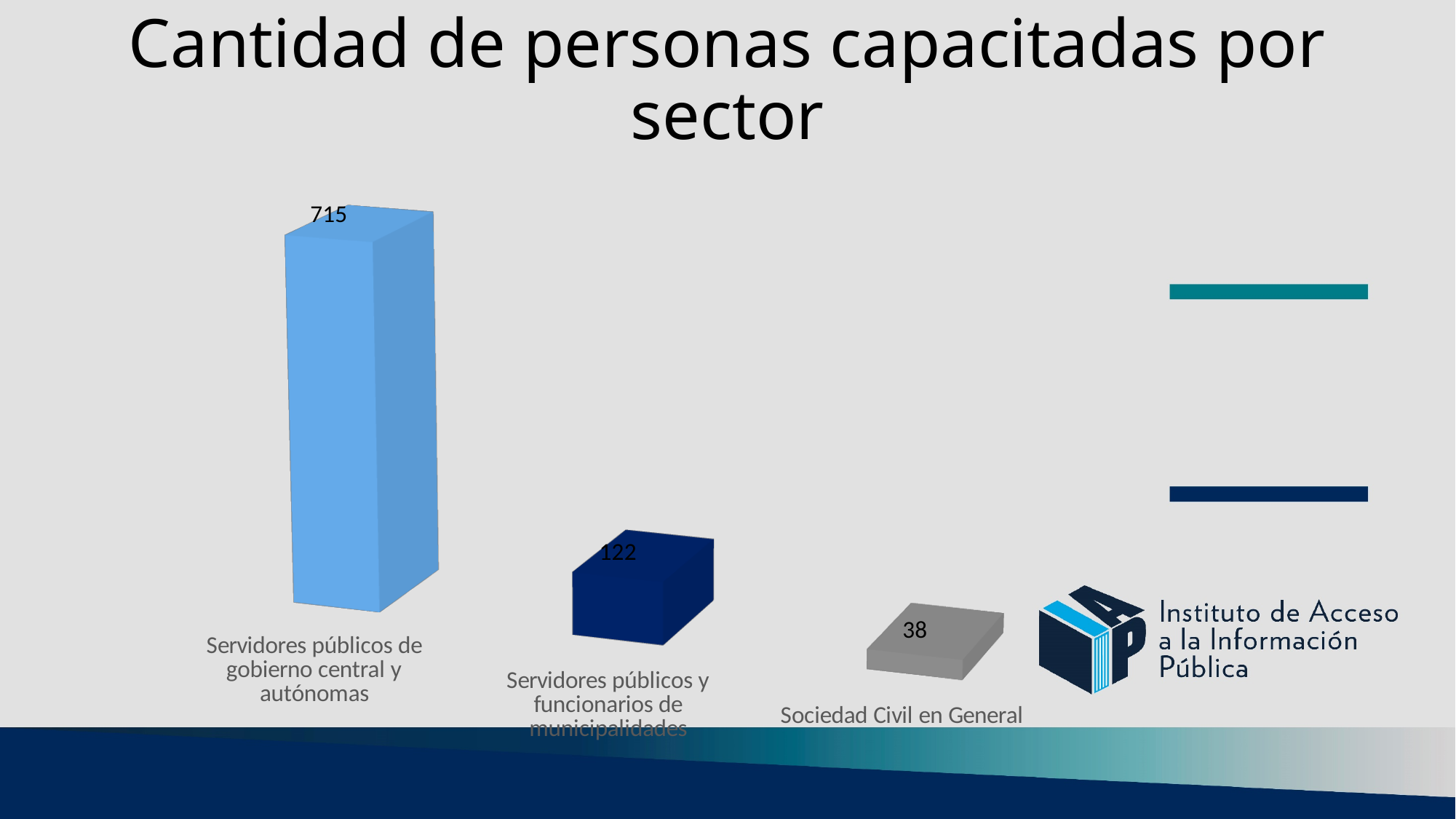
Which sector has the lowest number of people trained? Sociedad Civil en General What is the difference between the values for Servidores públicos de gobierno central y autónomas and Servidores públicos y funcionarios de municipalidades? 593 What is the value for Sociedad Civil en General? 38 Which is larger: the value for Servidores públicos y funcionarios de municipalidades or the value for Sociedad Civil en General? Servidores públicos y funcionarios de municipalidades What kind of chart is shown on the slide? Bar chart What is the difference between the values for Servidores públicos y funcionarios de municipalidades and Sociedad Civil en General? 84 What is the title of the chart? Cantidad de personas capacitadas por sector Do the values rise or fall from left to right across the sectors? Fall What is the value for Servidores públicos y funcionarios de municipalidades? 122 What is the value for Servidores públicos de gobierno central y autónomas? 715 Which sector has the highest number of people trained? Servidores públicos de gobierno central y autónomas How many sectors are shown in the chart? 3